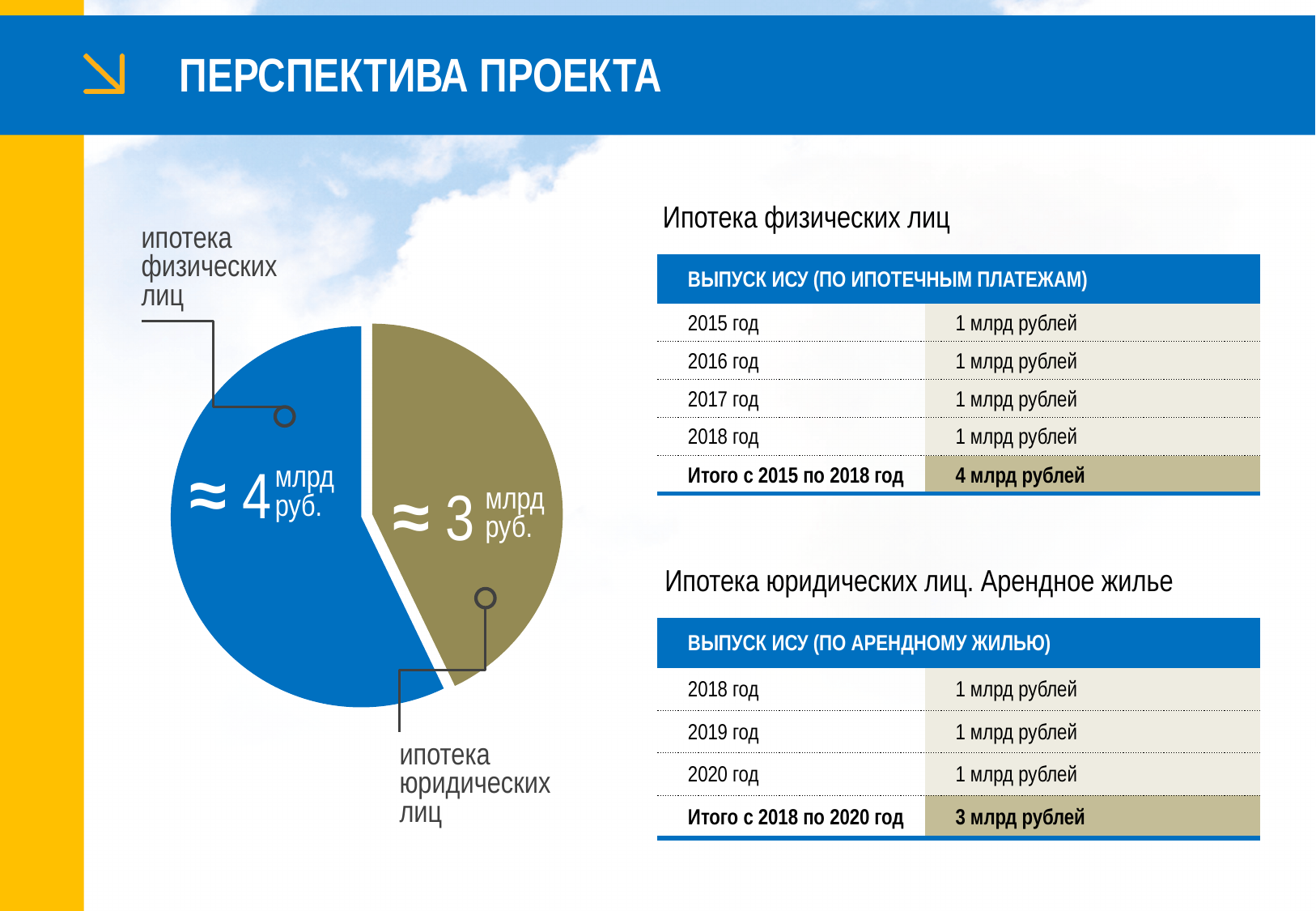
What value is printed on the pie slice for ипотека юридических лиц? ≈ 3 млрд руб. What colour is the slice for ипотека физических лиц in the pie chart? blue Which is larger in the pie chart: ипотека физических лиц or ипотека юридических лиц? ипотека физических лиц What kind of chart is shown on the slide? pie chart Which slice of the pie chart is the largest? ипотека физических лиц What colour is the slice for ипотека юридических лиц in the pie chart? olive/khaki What value is printed on the pie slice for ипотека физических лиц? ≈ 4 млрд руб. How many slices does the pie chart have? 2 Which slice of the pie chart is the smallest? ипотека юридических лиц